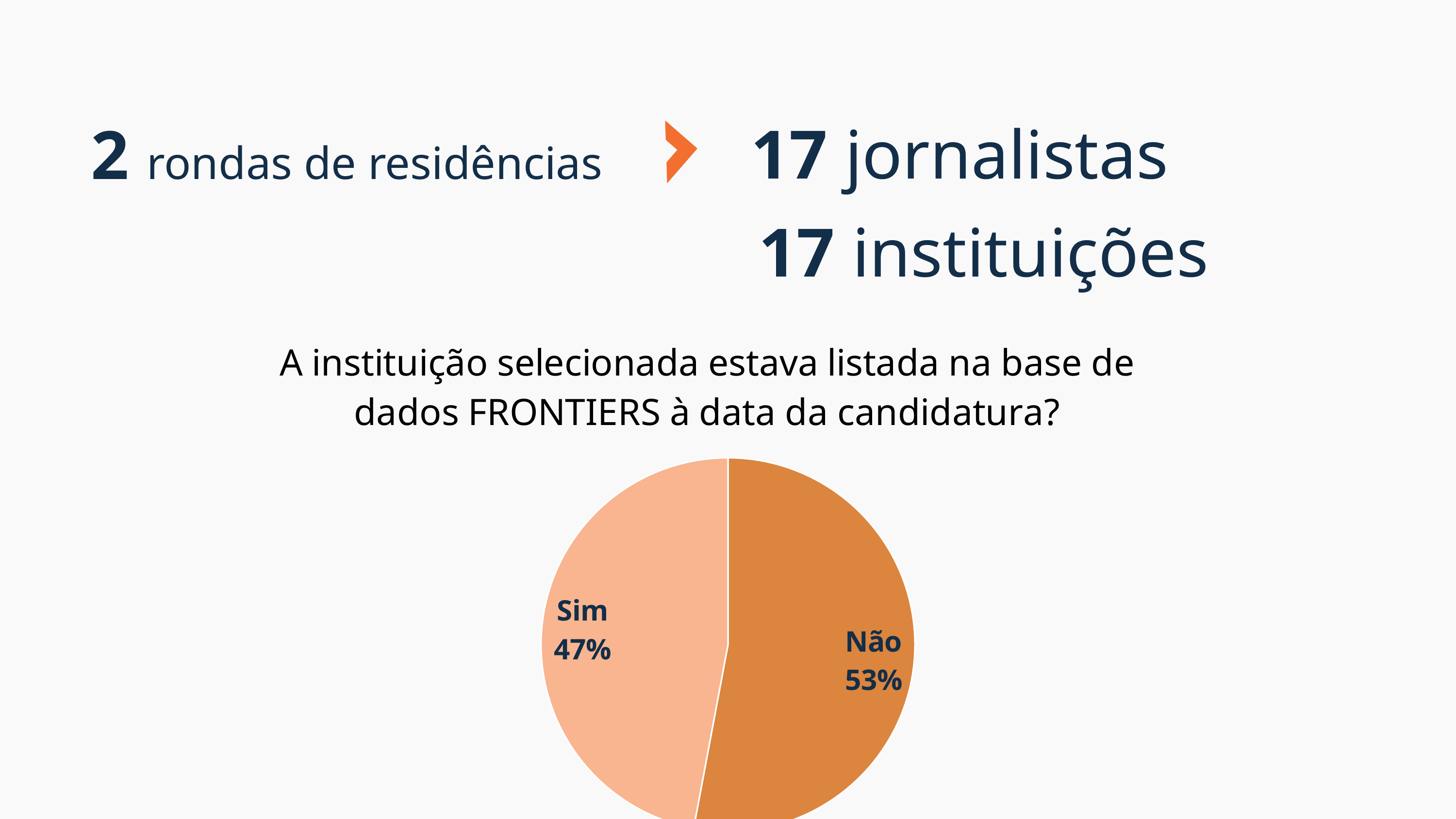
What kind of chart is shown on the slide? pie chart What question does the pie chart answer, according to the text above it? A instituição selecionada estava listada na base de dados FRONTIERS à data da candidatura? How many slices does the pie chart have? 2 Which slice of the pie is the largest? Não Which is larger, the "Sim" slice or the "Não" slice? Não What share of the pie does the "Sim" slice represent? 47% What share of the pie does the "Não" slice represent? 53% Which slice of the pie is shown in the darker orange colour? Não Which slice of the pie is the smallest? Sim What is the difference in percentage points between the "Não" and "Sim" slices? 6